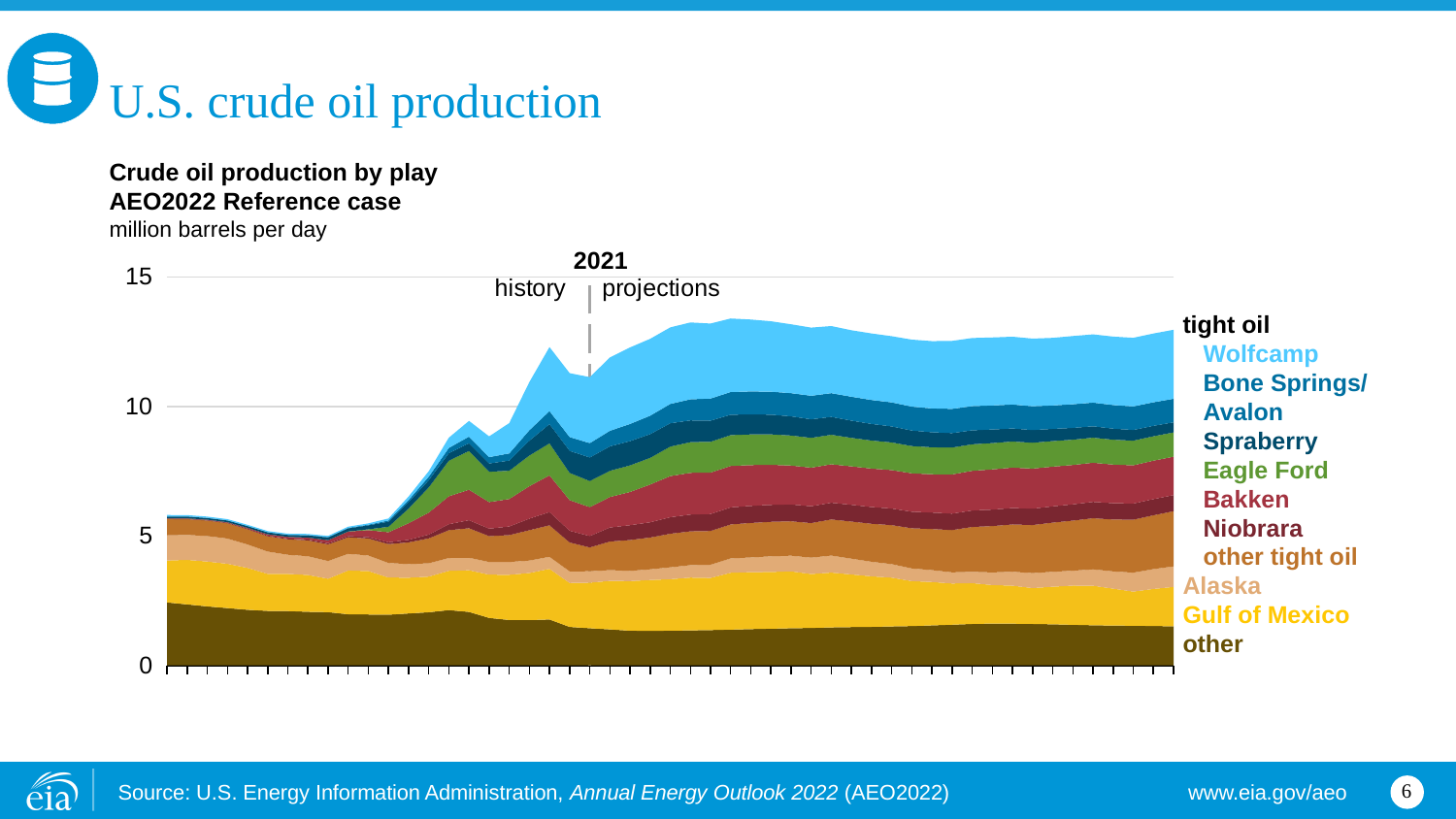
Overall, does total crude oil production rise or fall from the left end of the chart to the right end? rise What is the highest value shown on the vertical axis? 15 Is the total crude oil production at the left end of the chart greater or less than 10 million barrels per day? less Does the total crude oil production ever exceed 15 million barrels per day on the chart? no How many series does the legend list? 10 Which year separates history from projections on the chart? 2021 Is the total crude oil production at the left end of the chart greater or less than 5 million barrels per day? greater What unit is crude oil production measured in on the chart? million barrels per day What kind of chart is shown on the slide? stacked area chart